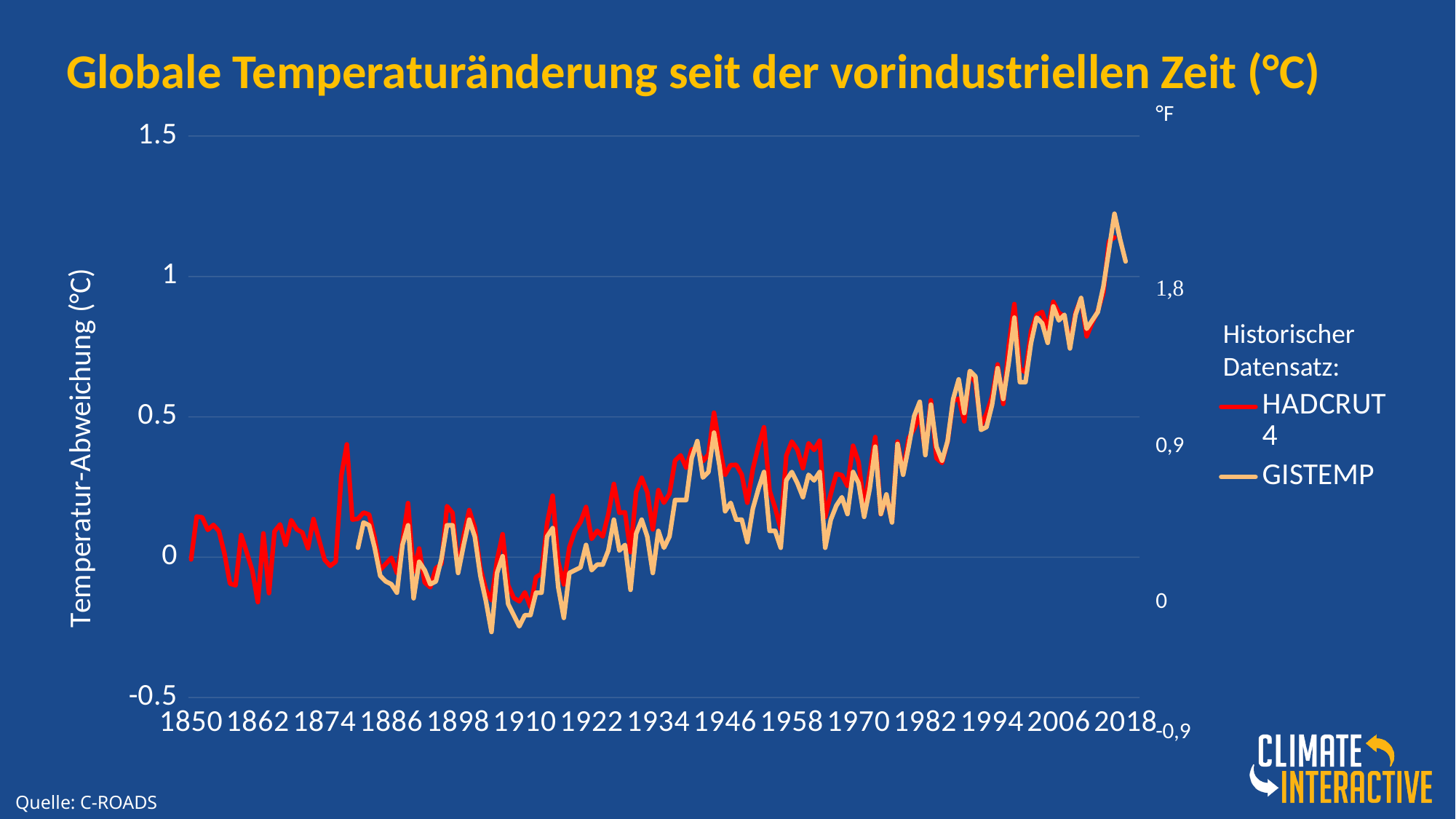
How many year labels are shown on the x axis? 15 What is the last year shown on the x axis? 2018 Is the HADCRUT4 value around 2006 greater or less than 0.5? greater What are the two series named in the legend? HADCRUT4 and GISTEMP Is the GISTEMP value around 1910 greater or less than 0? less Is the highest value reached by the GISTEMP line greater or less than 1? greater What is the first year shown on the x axis? 1850 What kind of chart is shown on the slide? line chart Do the temperature values generally rise or fall from 1850 to 2018? rise What is the title of the chart? Globale Temperaturänderung seit der vorindustriellen Zeit (°C) How many series does the legend list? 2